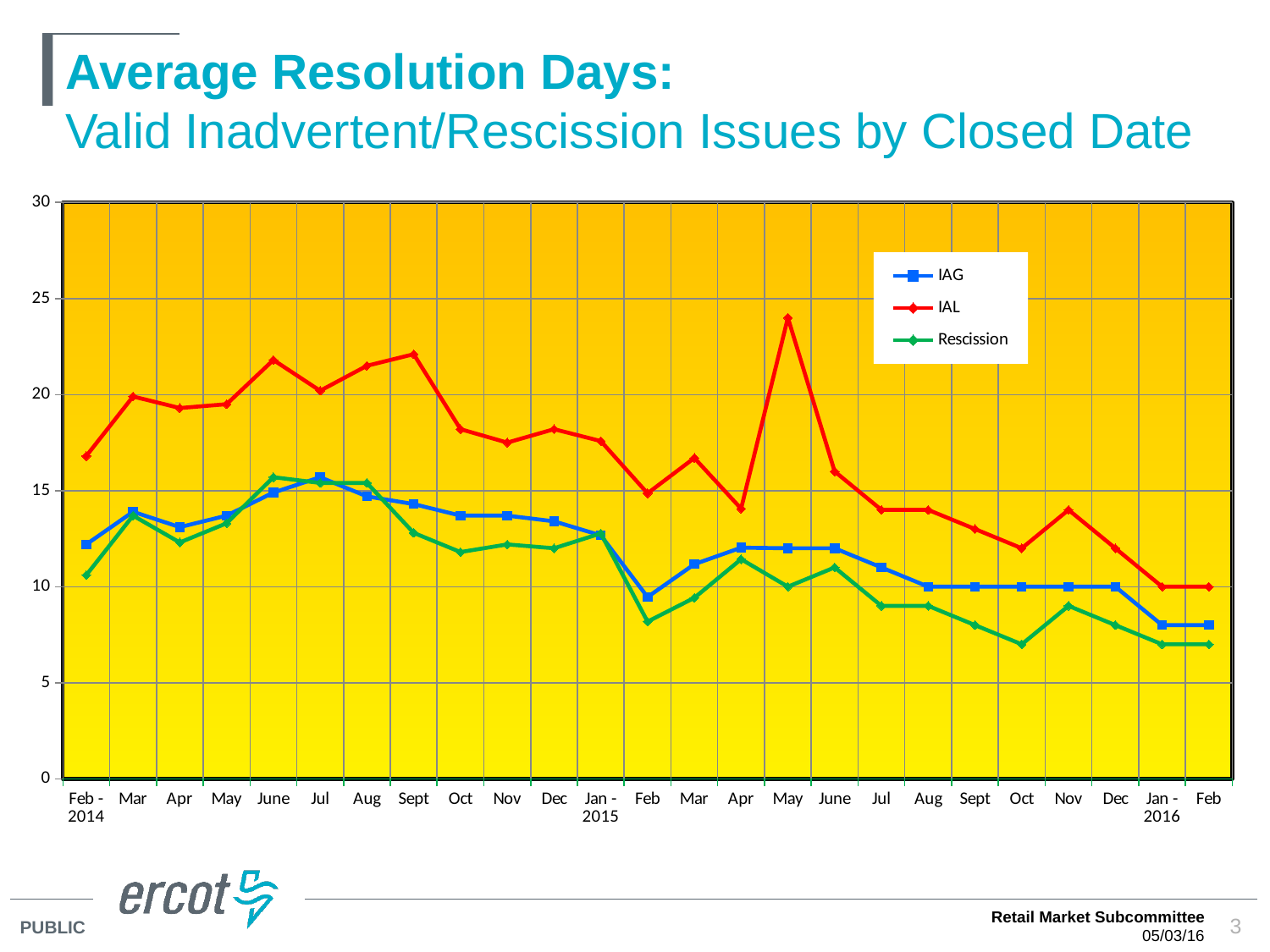
Is the IAL value for May 2015 greater or less than 20? greater How many months are plotted along the x axis? 25 In May 2015, which series has the larger value, IAL or IAG? IAL Is the IAL value for June 2014 greater or less than 20? greater Is the IAL value for Feb 2014 greater or less than 15? greater What kind of chart is shown on the slide? line chart Does the IAG series rise or fall from Aug 2015 to Feb 2016? fall How many series does the legend list? 3 In Feb 2014, which series has the larger value, IAG or Rescission? IAG In which month does the IAL series reach its highest value? May 2015